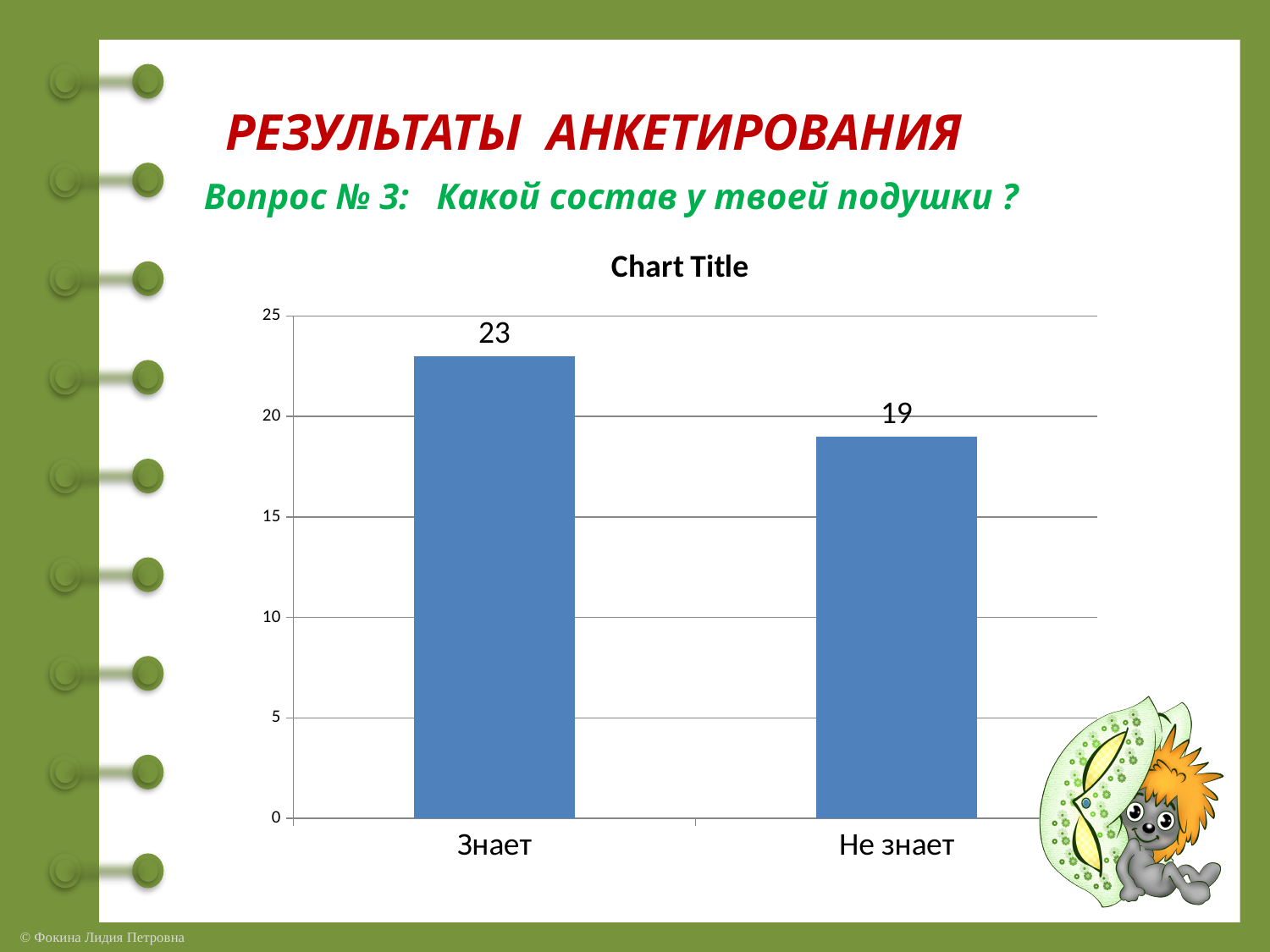
What is the value for Знает? 23 Which category has the highest value? Знает Is the value for Не знает greater or less than 20? less What is the value for Не знает? 19 Which category has the lowest value? Не знает What is the highest value shown on the vertical axis? 25 Which is larger, the value for Знает or the value for Не знает? Знает What is the difference between the values for Знает and Не знает? 4 Is the value for Знает greater or less than 20? greater How many categories are shown on the chart? 2 What kind of chart is shown on the slide? bar chart What is the title shown above the chart? Chart Title